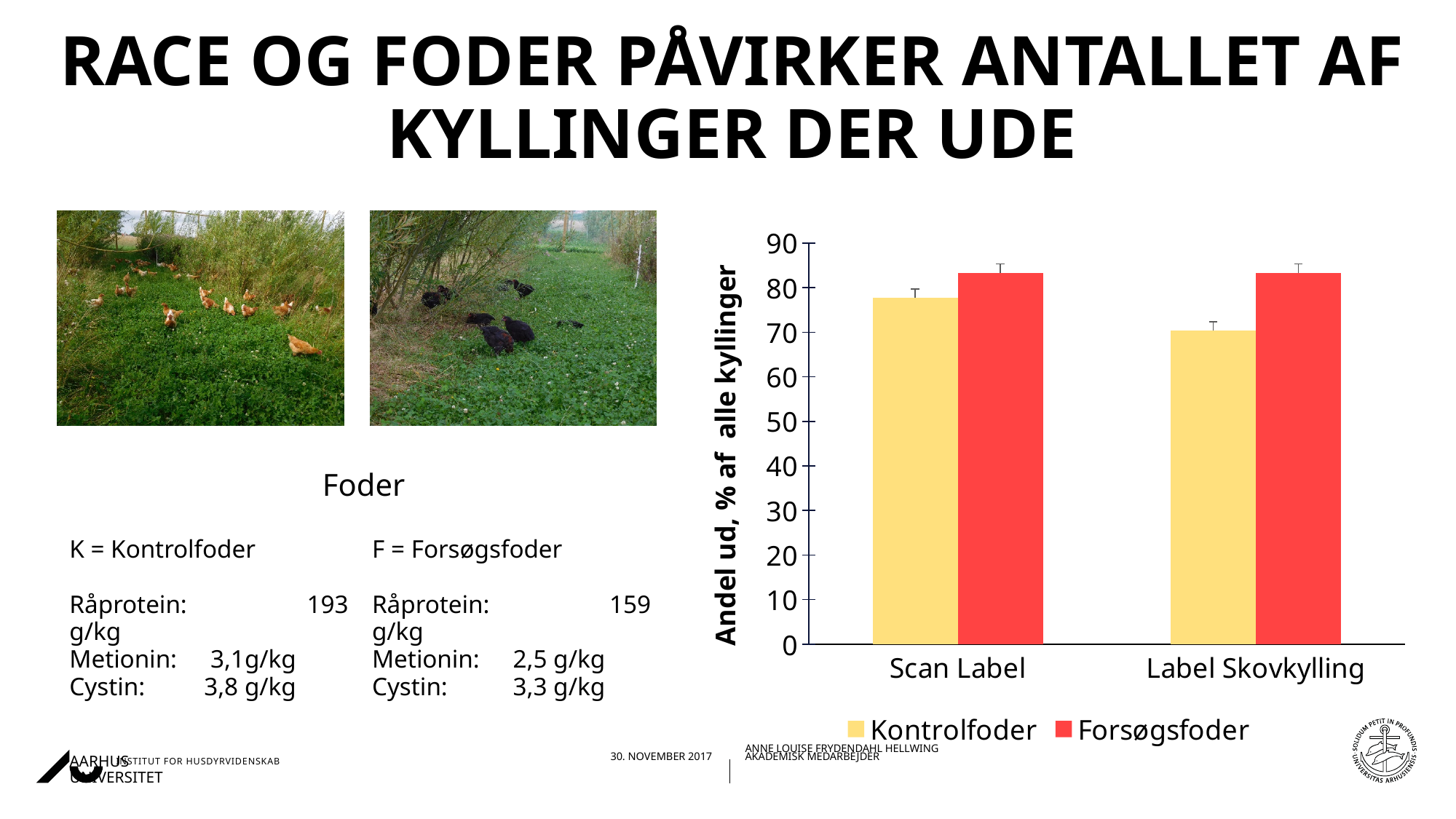
Which bar in the chart has the lowest value? Kontrolfoder for Label Skovkylling Is the Forsøgsfoder value for Scan Label greater or less than 80? greater Which series does the legend list first? Kontrolfoder For the Kontrolfoder series, which category has the larger value, Scan Label or Label Skovkylling? Scan Label What kind of chart is shown on the slide? bar chart Is the Kontrolfoder value for Scan Label greater or less than 70? greater Is the Kontrolfoder value for Label Skovkylling greater or less than 80? less How many series does the chart legend list? 2 For Label Skovkylling, which series has the larger value, Kontrolfoder or Forsøgsfoder? Forsøgsfoder What is the label of the vertical axis of the chart? Andel ud, % af alle kyllinger How many categories are shown on the x axis of the chart? 2